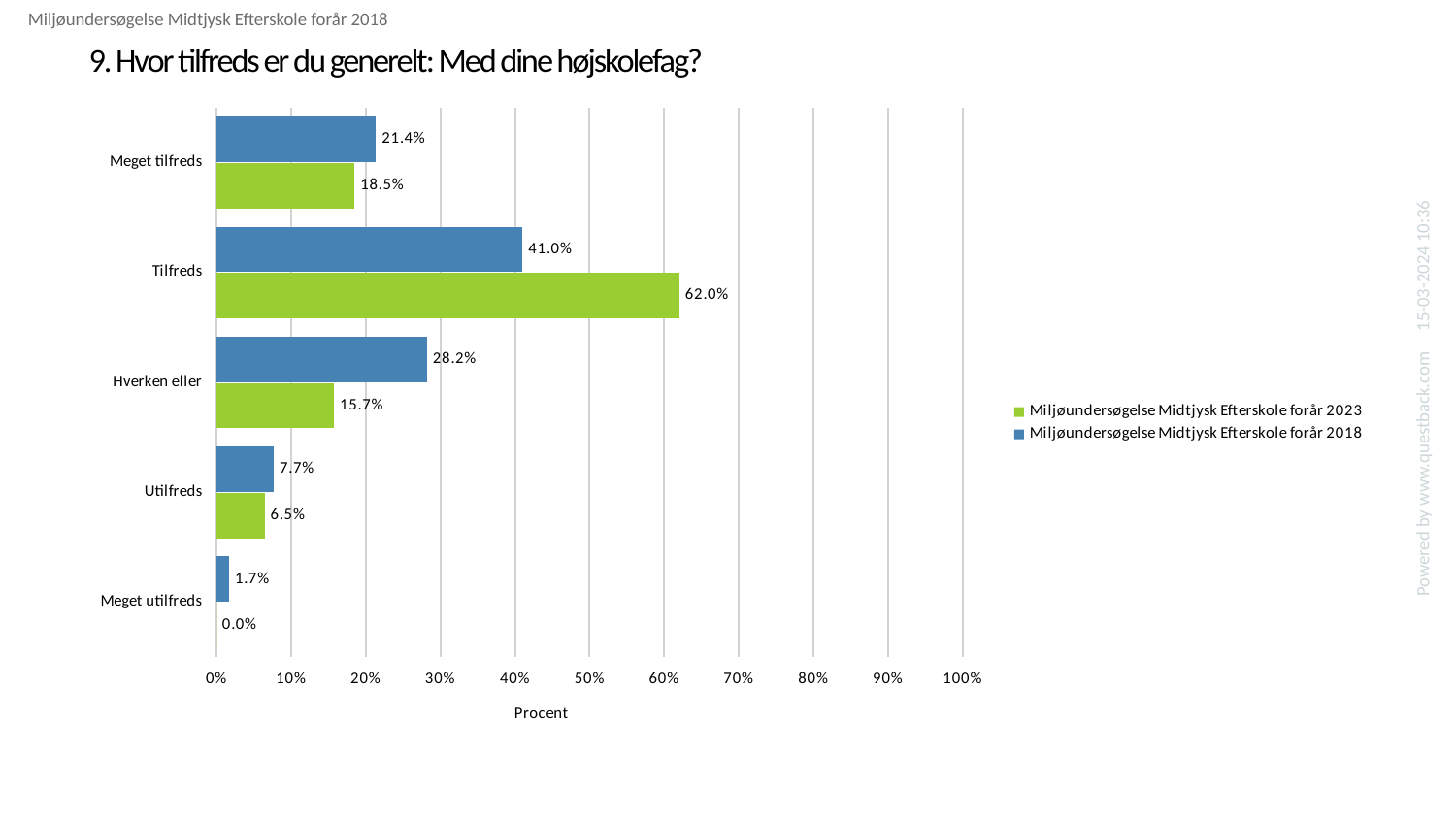
How many series does the legend list? 2 What is the value for Hverken eller in the Miljøundersøgelse Midtjysk Efterskole forår 2018 series? 28.2% What is the value for Meget utilfreds in the Miljøundersøgelse Midtjysk Efterskole forår 2023 series? 0.0% What is the label of the x axis? Procent What is the value for Tilfreds in the Miljøundersøgelse Midtjysk Efterskole forår 2023 series? 62.0% Is the value for Hverken eller in the 2018 series greater or less than 20%? greater What is the difference between the 2023 and 2018 values for Tilfreds? 21.0% How many categories are shown on the chart? 5 Which category has the lowest value in the Miljøundersøgelse Midtjysk Efterskole forår 2023 series? Meget utilfreds Which category has the highest value in the Miljøundersøgelse Midtjysk Efterskole forår 2018 series? Tilfreds What kind of chart is shown on the slide? Bar chart Which series has the larger value for Meget tilfreds, 2023 or 2018? Miljøundersøgelse Midtjysk Efterskole forår 2018